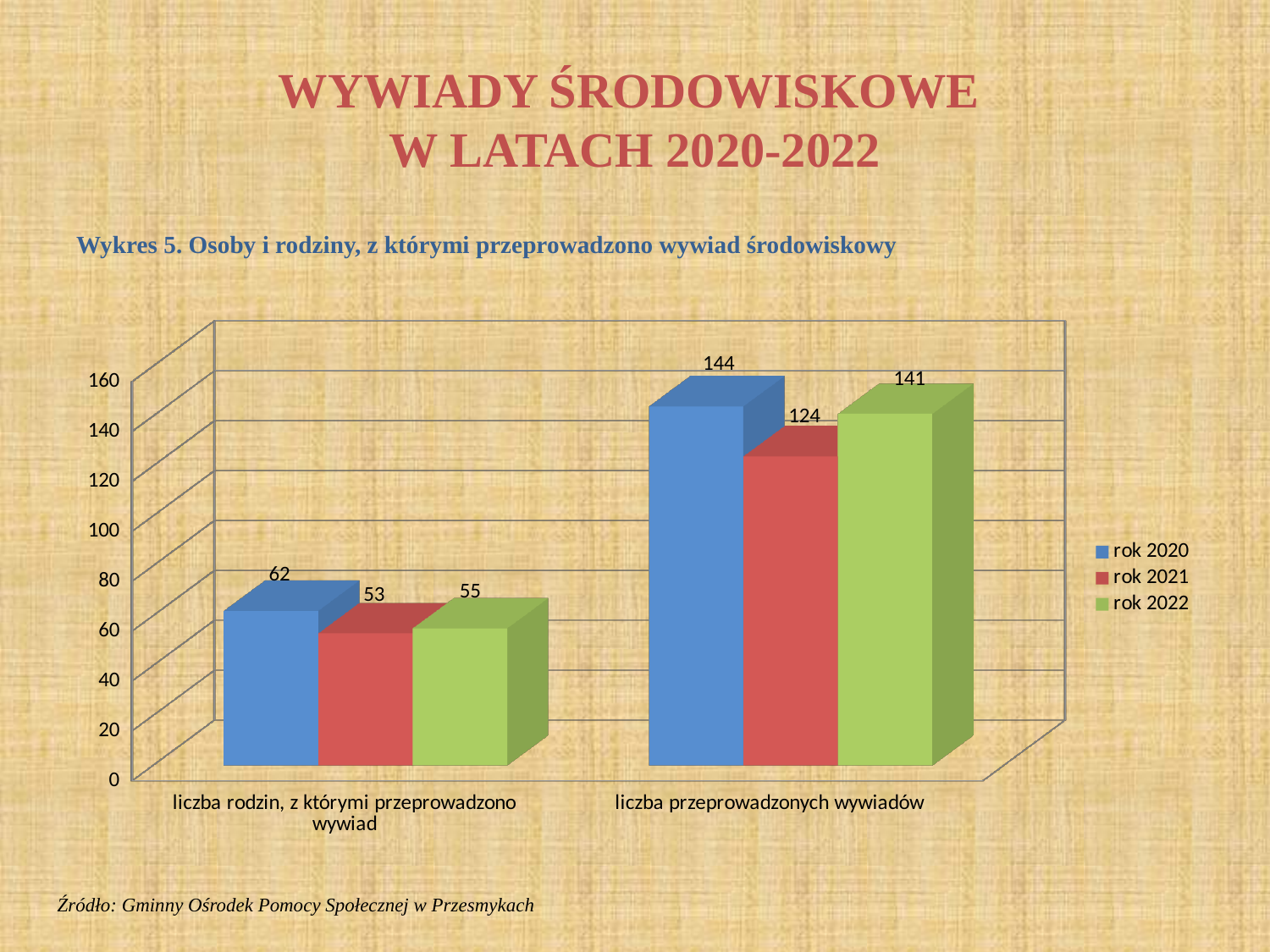
How many categories are shown on the x axis? 2 Which year has the lowest value for 'liczba rodzin, z którymi przeprowadzono wywiad'? rok 2021 What is the value for 'rok 2022' in the category 'liczba rodzin, z którymi przeprowadzono wywiad'? 55 Which is larger for 'liczba rodzin, z którymi przeprowadzono wywiad': the value for 'rok 2021' or 'rok 2022'? rok 2022 What is the value for 'rok 2020' in the category 'liczba rodzin, z którymi przeprowadzono wywiad'? 62 Which year has the highest value for 'liczba przeprowadzonych wywiadów'? rok 2020 What is the difference between the 'rok 2020' and 'rok 2021' values for 'liczba przeprowadzonych wywiadów'? 20 Is the value for 'rok 2022' in 'liczba przeprowadzonych wywiadów' greater or less than 120? greater What is the title of the chart (Wykres 5)? Osoby i rodziny, z którymi przeprowadzono wywiad środowiskowy What is the value for 'rok 2021' in the category 'liczba przeprowadzonych wywiadów'? 124 How many series does the legend list? 3 What kind of chart is shown on the slide? bar chart